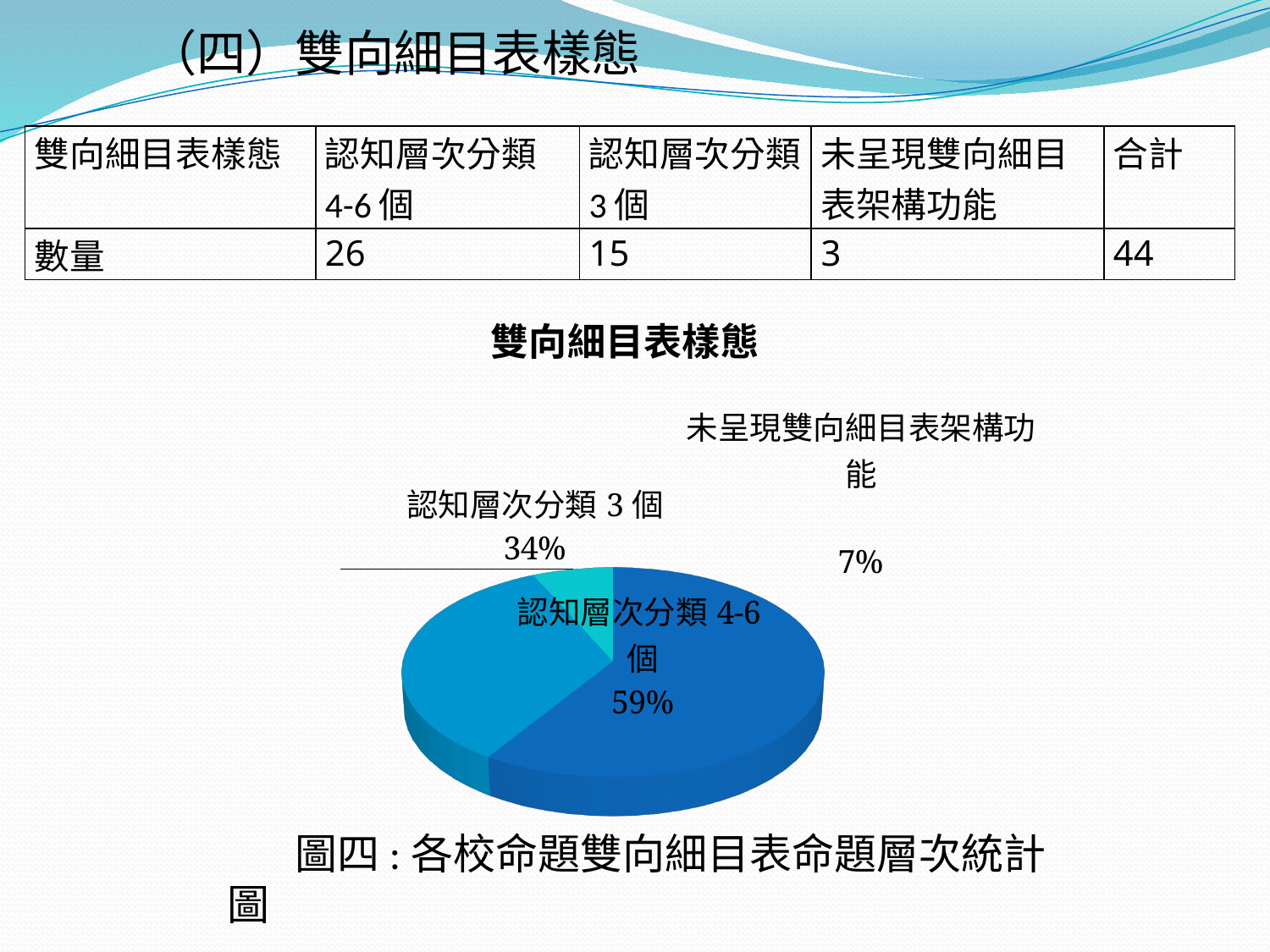
What is the difference in percentage points between the 認知層次分類 4-6 個 slice and the 認知層次分類 3 個 slice? 25 What is the caption printed below the pie chart? 圖四 : 各校命題雙向細目表命題層次統計圖 What is the difference in percentage points between the 認知層次分類 3 個 slice and the 未呈現雙向細目表架構功能 slice? 27 Which slice of the pie chart is the smallest? 未呈現雙向細目表架構功能 What kind of chart is shown on the slide? pie chart What is the chart's title? 雙向細目表樣態 What share of the pie does 未呈現雙向細目表架構功能 take? 7% Which is larger in the pie chart: 認知層次分類 3 個 or 未呈現雙向細目表架構功能? 認知層次分類 3 個 What share of the pie does 認知層次分類 4-6 個 take? 59% Which slice of the pie chart is the largest? 認知層次分類 4-6 個 How many slices does the pie chart have? 3 What share of the pie does 認知層次分類 3 個 take? 34%